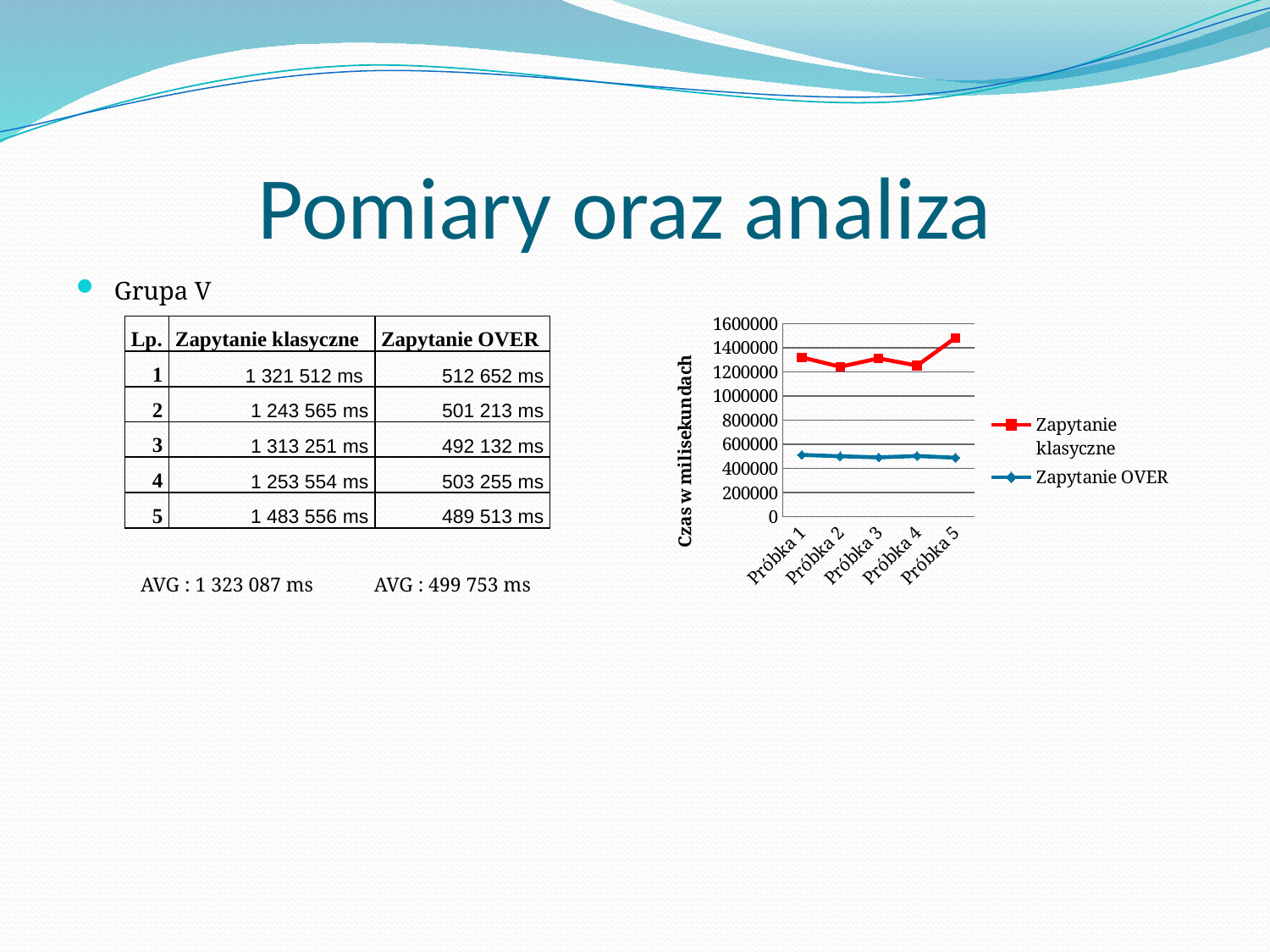
Does the Zapytanie klasyczne series rise or fall from Próbka 4 to Próbka 5? rise Is the value for Zapytanie OVER at Próbka 3 greater or less than 400000? greater What kind of chart is shown on the slide? line chart What is the label of the vertical axis of the chart? Czas w milisekundach At Próbka 3, which series has the larger value: Zapytanie klasyczne or Zapytanie OVER? Zapytanie klasyczne Which sample has the highest value for the Zapytanie klasyczne series in the chart? Próbka 5 Which colour is used for the Zapytanie OVER series in the chart? blue Is the value for Zapytanie klasyczne at Próbka 5 greater or less than 1400000? greater How many samples (Próbka) are plotted along the x axis of the chart? 5 Is the value for Zapytanie OVER at Próbka 1 greater or less than 600000? less How many series does the chart legend list? 2